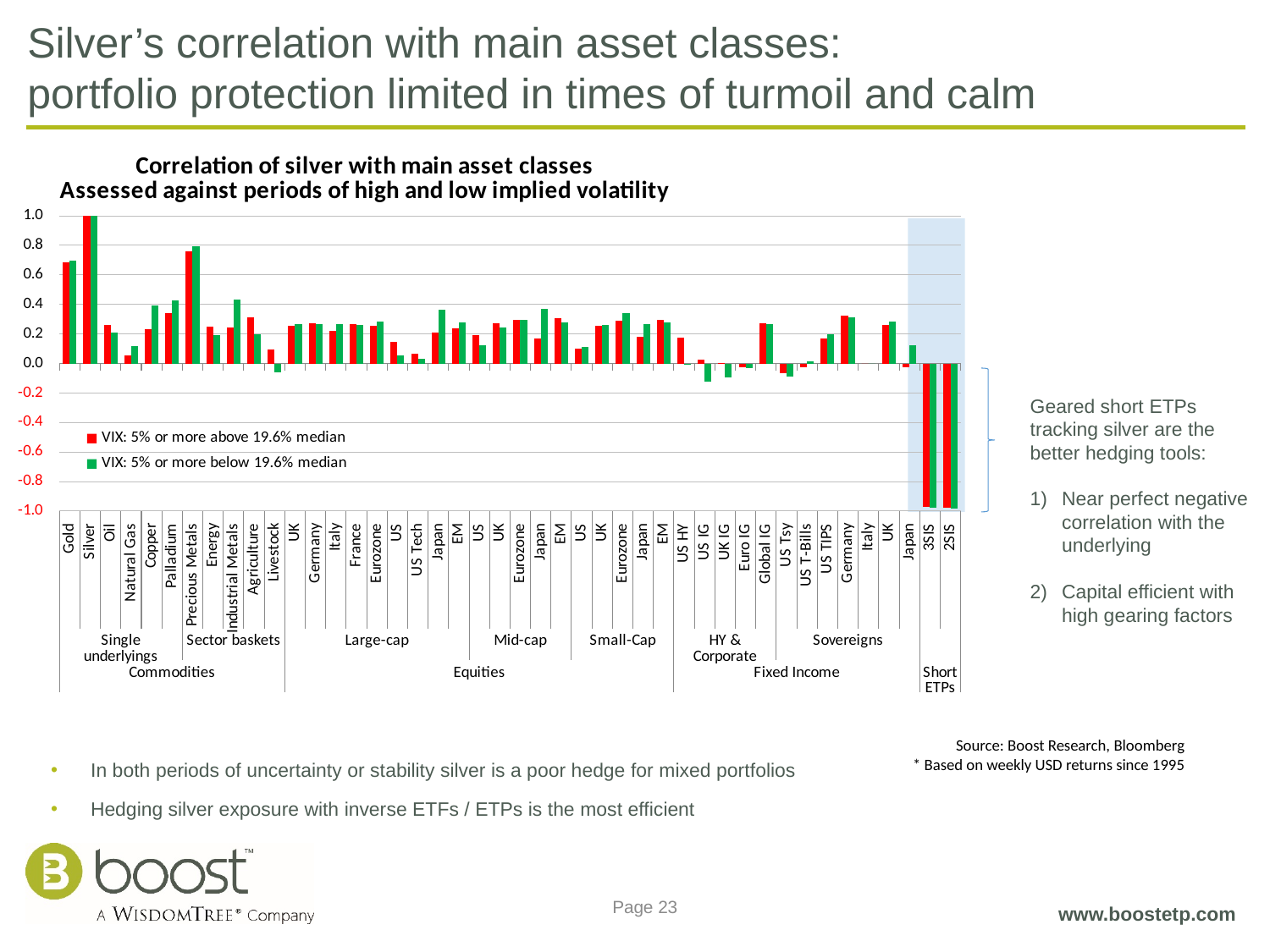
Is the value for Precious Metals in the 'VIX: 5% or more below 19.6% median' series greater or less than 0.6? greater Is the value for Gold in the 'VIX: 5% or more above 19.6% median' series greater or less than 0.6? greater Is the value for 3SIS in the 'VIX: 5% or more above 19.6% median' series greater or less than -0.8? less Which category has the highest correlation with silver in the chart? Silver What is the correlation value for Silver in the 'VIX: 5% or more above 19.6% median' series? 1.0 What kind of chart is shown on the slide? bar chart What are the two legend entries of the chart? VIX: 5% or more above 19.6% median; VIX: 5% or more below 19.6% median How many series does the chart's legend list? 2 Which has the larger value in the 'VIX: 5% or more below 19.6% median' series, Precious Metals or Energy? Precious Metals What is the title of the chart? Correlation of silver with main asset classes Assessed against periods of high and low implied volatility Which has the larger value in the 'VIX: 5% or more above 19.6% median' series, Gold or Oil? Gold